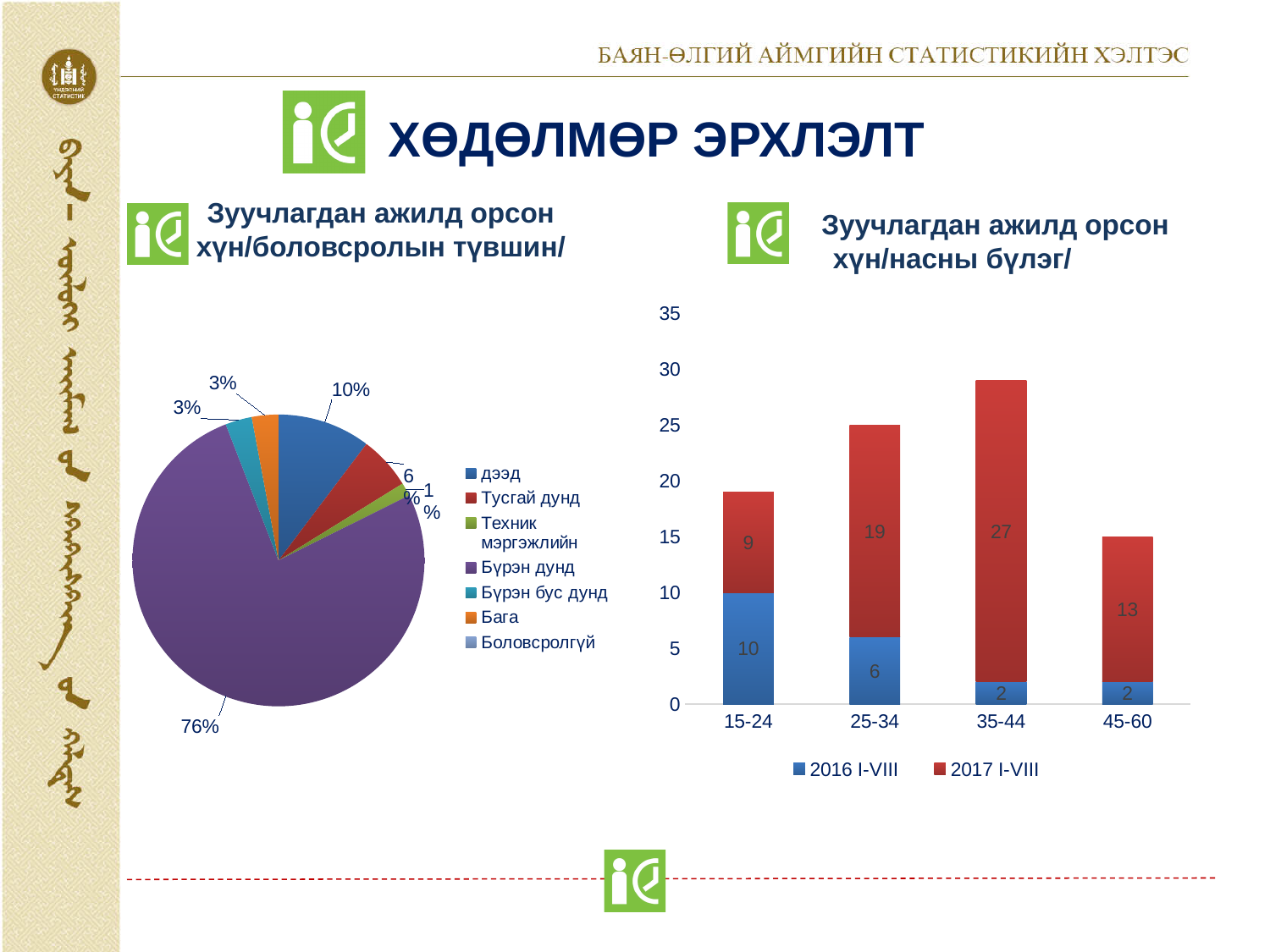
In the pie chart 'Зуучлагдан ажилд орсон хүн/боловсролын түвшин/', what share does 'дээд' have? 10% In the bar chart 'Зуучлагдан ажилд орсон хүн/насны бүлэг/', what is the total of the stacked bar for the 25-34 age group? 25 In the pie chart 'Зуучлагдан ажилд орсон хүн/боловсролын түвшин/', what share does 'Бүрэн дунд' have? 76% What type of chart is the one on the left of the slide, titled 'Зуучлагдан ажилд орсон хүн/боловсролын түвшин/'? Pie chart In the pie chart 'Зуучлагдан ажилд орсон хүн/боловсролын түвшин/', which category has the largest slice? Бүрэн дунд In the bar chart 'Зуучлагдан ажилд орсон хүн/насны бүлэг/', which age group has the highest value for 2017 I-VIII? 35-44 In the bar chart 'Зуучлагдан ажилд орсон хүн/насны бүлэг/', what is the value for 2017 I-VIII in the 35-44 age group? 27 In the bar chart 'Зуучлагдан ажилд орсон хүн/насны бүлэг/', what is the value for 2016 I-VIII in the 15-24 age group? 10 In the bar chart 'Зуучлагдан ажилд орсон хүн/насны бүлэг/', which is larger for the 15-24 age group: 2016 I-VIII or 2017 I-VIII? 2016 I-VIII How many series does the legend of the bar chart 'Зуучлагдан ажилд орсон хүн/насны бүлэг/' list? 2 In the bar chart 'Зуучлагдан ажилд орсон хүн/насны бүлэг/', what is the difference between the 2017 I-VIII and 2016 I-VIII values for the 45-60 age group? 11 How many age groups are shown on the x axis of the bar chart 'Зуучлагдан ажилд орсон хүн/насны бүлэг/'? 4